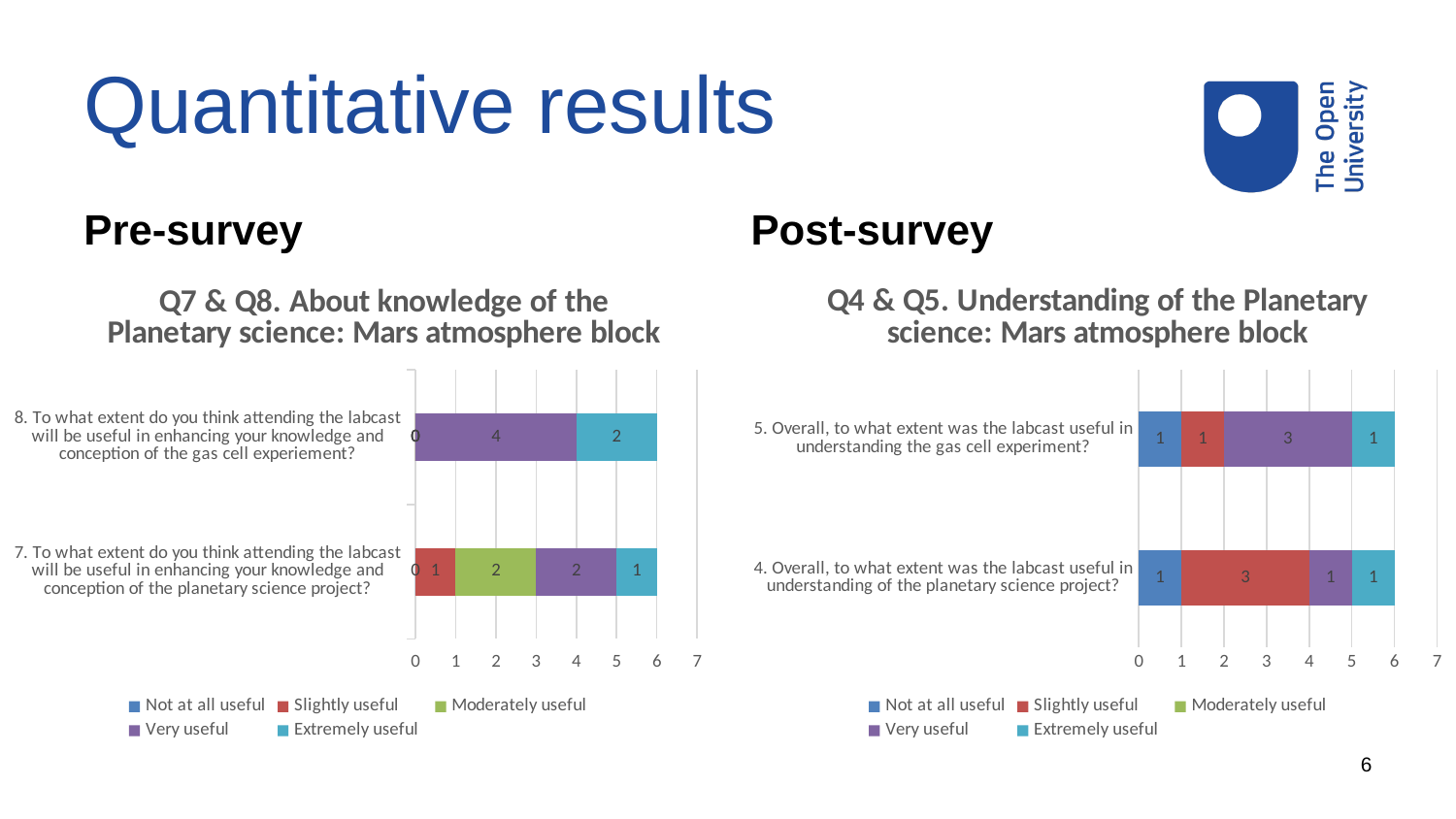
What is the title of the Pre-survey chart? Q7 & Q8. About knowledge of the Planetary science: Mars atmosphere block In the Pre-survey chart, what is the difference between the 'Very useful' and 'Extremely useful' values for question 8? 2 In the Pre-survey chart, what is the total of the stacked bar for question 7 (planetary science project)? 6 In the Pre-survey chart, how many respondents chose 'Very useful' for question 8 (gas cell experiment)? 4 In the Post-survey chart, what is the 'Very useful' value for question 5 (gas cell experiment)? 3 How many survey questions (categories) are plotted in the Pre-survey chart? 2 In the Post-survey chart, what is the 'Slightly useful' value for question 4 (planetary science project)? 3 How many series does the legend of the Post-survey chart (Q4 & Q5) list? 5 What kind of chart is the Pre-survey chart (Q7 & Q8)? Bar chart In the Post-survey chart, which question has the larger 'Slightly useful' value, question 4 or question 5? Question 4 In the Post-survey chart, what is the total of the stacked bar for question 5 (gas cell experiment)? 6 In the Pre-survey chart, what is the 'Moderately useful' value for question 7 (planetary science project)? 2